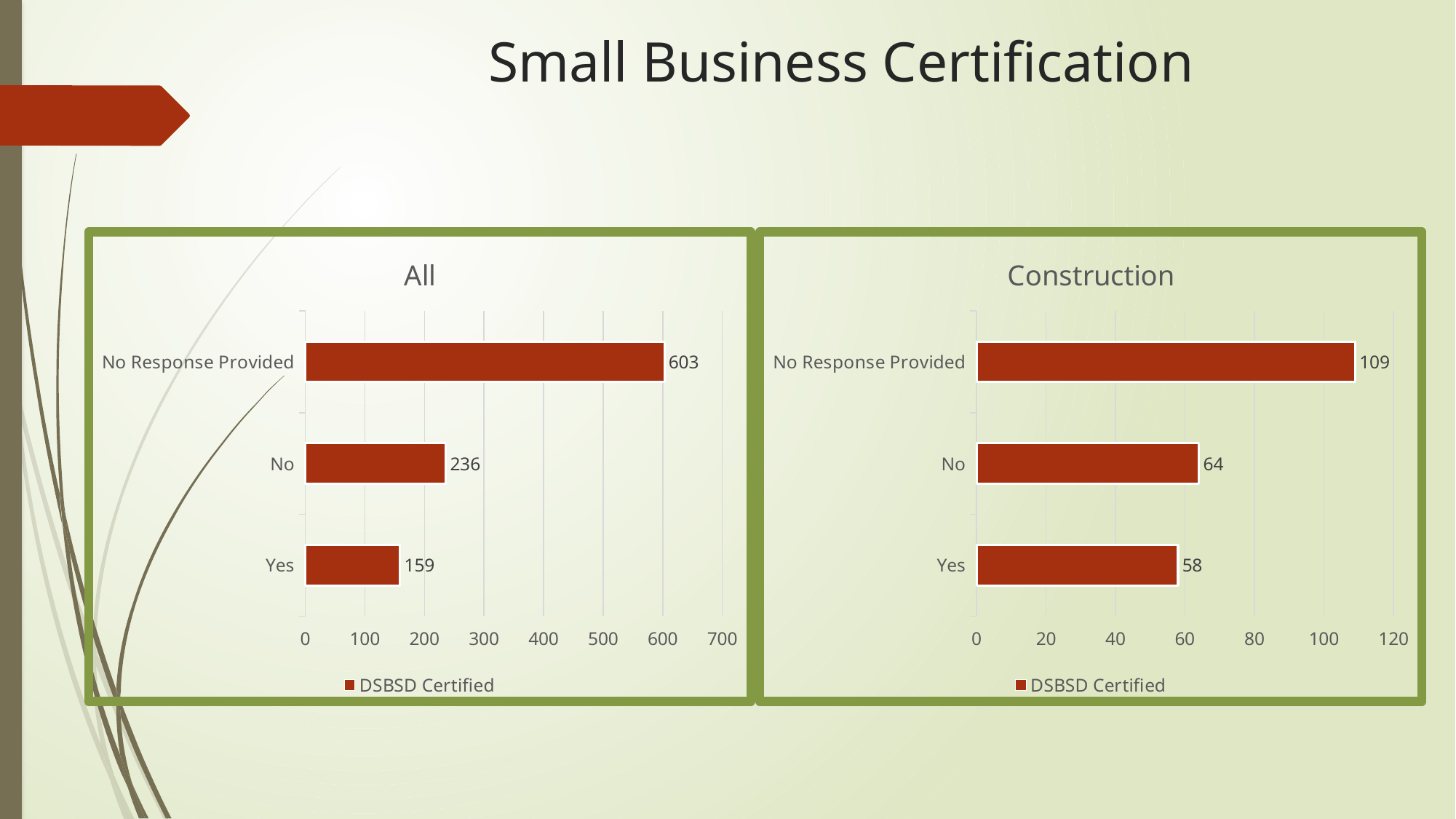
What series name does the legend of the 'All' chart show? DSBSD Certified In the 'All' chart, what is the value for Yes? 159 In the 'All' chart, which category has the highest value? No Response Provided How many categories does the 'All' chart show? 3 In the 'Construction' chart, which category has the lowest value? Yes In the 'All' chart, what is the value for No Response Provided? 603 In the 'Construction' chart, what is the value for No? 64 In the 'All' chart, what is the difference between the values for No and Yes? 77 In the 'Construction' chart, what is the value for Yes? 58 What kind of chart is the 'Construction' chart? bar chart In the 'Construction' chart, what is the difference between the values for No Response Provided and No? 45 In the 'Construction' chart, which is larger, the value for No or the value for Yes? No